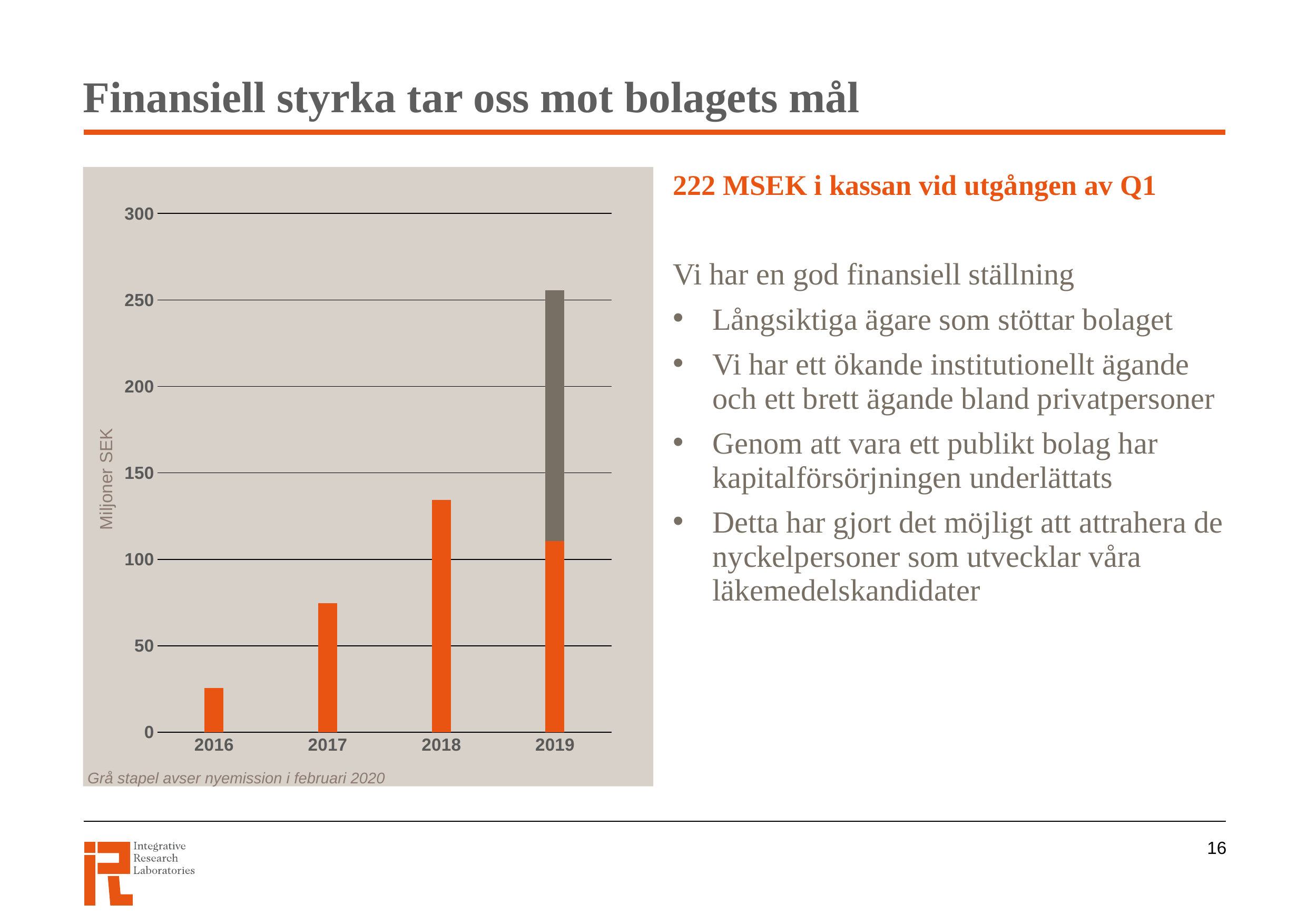
Is the total height of the 2019 bar (orange plus grey) greater or less than 200? greater Is the value for 2017 greater or less than 50? greater Which year has the lowest bar in the chart? 2016 What kind of chart is shown on the slide? bar chart Which is larger, the orange bar for 2018 or the orange bar for 2019? 2018 Is the value for 2016 greater or less than 50? less How many years are shown on the x axis of the chart? 4 What is the y-axis title of the chart? Miljoner SEK Which year has the tallest bar in total (including the grey segment)? 2019 According to the note below the chart, what does the grey bar represent? Nyemission i februari 2020 Do the orange bars rise or fall from 2016 to 2018? rise